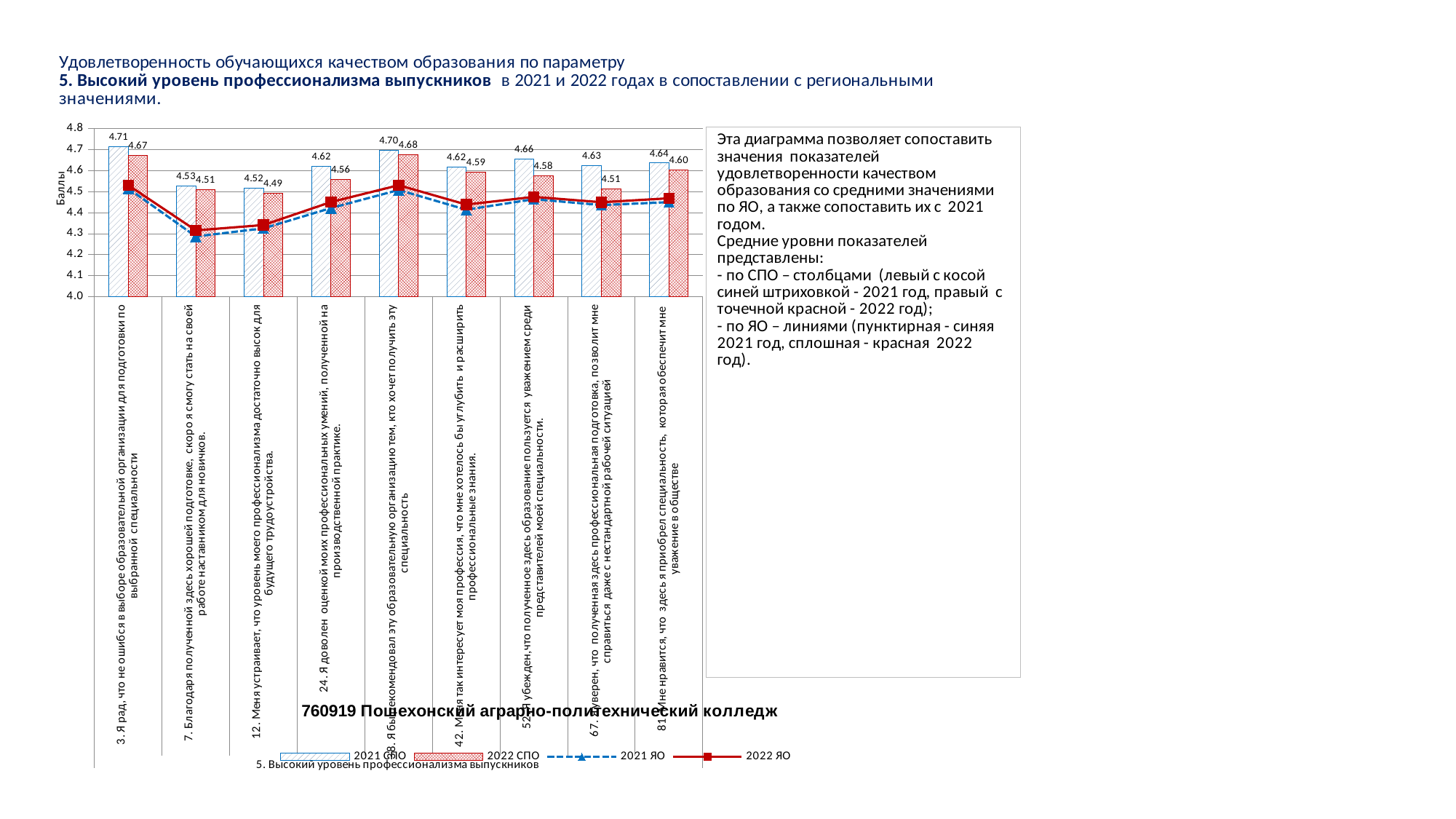
Which category has the highest 2021 СПО value? 3. Я рад, что не ошибся в выборе образовательной организации для подготовки по выбранной специальности What is the difference between the 2021 СПО and 2022 СПО values for the category "52. Я убежден, что полученное здесь образование пользуется уважением среди представителей моей специальности"? 0.08 For the category "38. Я бы рекомендовал эту образовательную организацию тем, кто хочет получить эту специальность", which is larger: the 2021 СПО value or the 2022 СПО value? 2021 СПО Which category has the lowest 2022 СПО value? 12. Меня устраивает, что уровень моего профессионализма достаточно высок для будущего трудоустройства What is the label of the vertical axis of the chart? Баллы How many series does the chart legend list? 4 What kind of chart is shown on the slide? Combined bar and line chart What is the 2021 СПО value for the category "3. Я рад, что не ошибся в выборе образовательной организации для подготовки по выбранной специальности"? 4.71 What is the 2022 СПО value for the category "24. Я доволен оценкой моих профессиональных умений, полученной на производственной практике"? 4.56 What is the 2022 СПО value for the category "67. Уверен, что полученная здесь профессиональная подготовка, позволит мне справиться даже с нестандартной рабочей ситуацией"? 4.51 How many categories are shown on the x axis of the chart? 9 Is the 2022 ЯО value for the category "7. Благодаря полученной здесь хорошей подготовке, скоро я смогу стать наставником для новичков" greater or less than 4.4? less